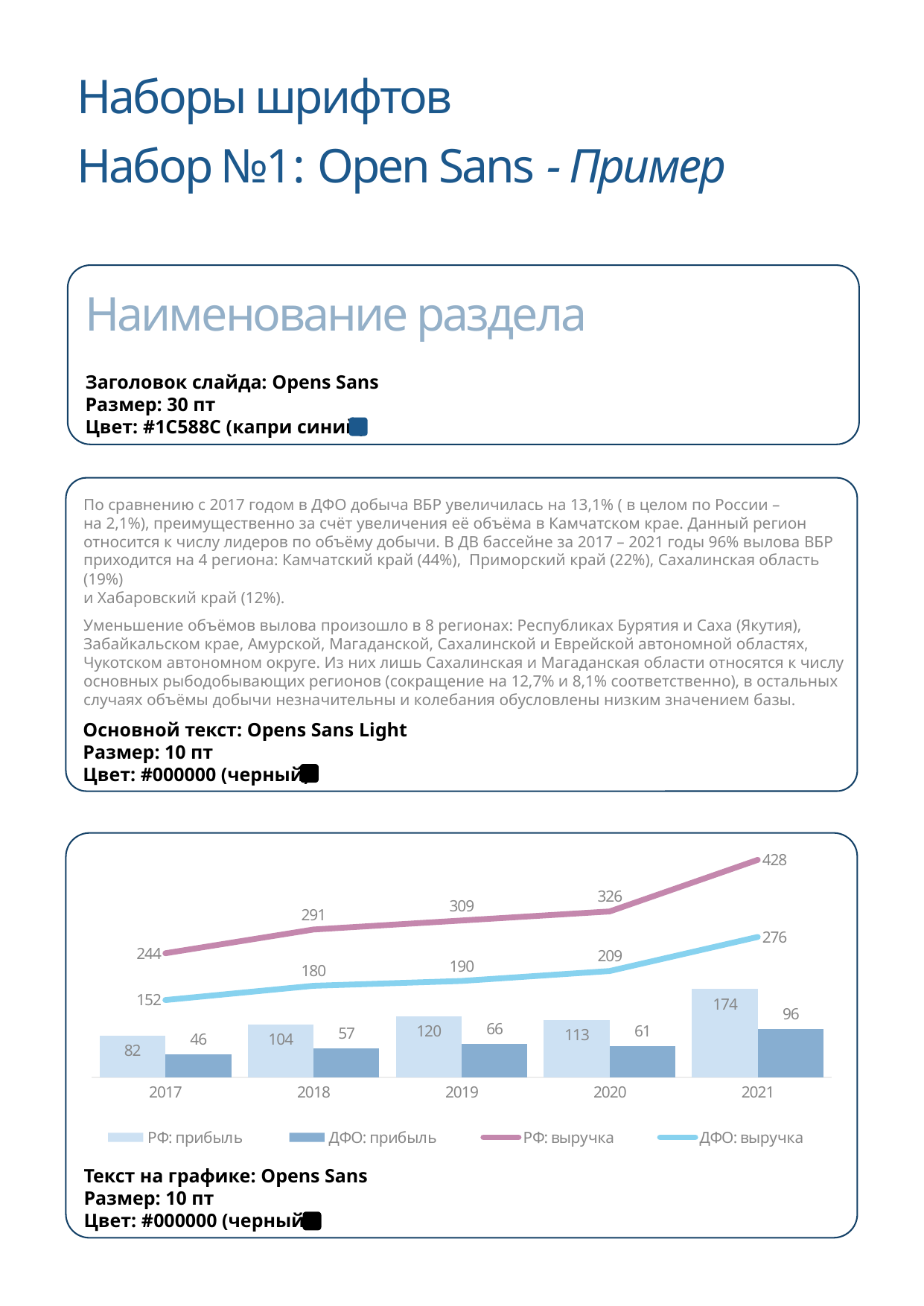
Does ДФО: выручка rise or fall from 2017 to 2021? rise What is the value of ДФО: прибыль in 2019? 66 What is the value of РФ: прибыль in 2020? 113 What is the value of ДФО: выручка in 2017? 152 What is the value of РФ: выручка in 2021? 428 What is the difference between РФ: выручка and ДФО: выручка in 2021? 152 Which series in the chart are drawn as lines rather than bars? РФ: выручка and ДФО: выручка How many series does the chart legend list? 4 In which year is РФ: прибыль the highest? 2021 Which is larger in 2020: РФ: прибыль or ДФО: прибыль? РФ: прибыль How many years are shown on the x axis of the chart? 5 In which year is ДФО: прибыль the lowest? 2017